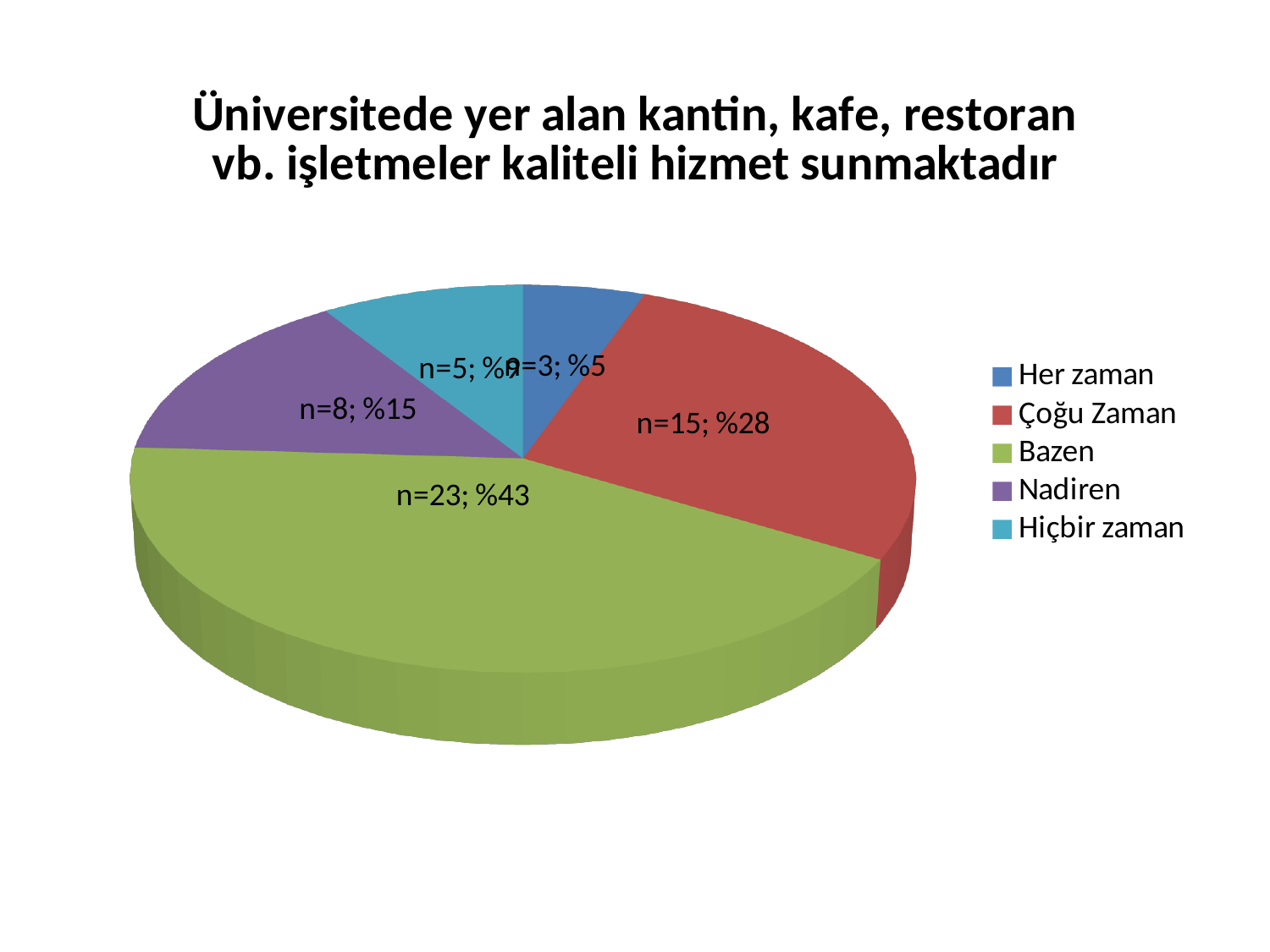
What colour is the Bazen slice in the pie chart? green What is the data label for the Bazen slice? n=23; %43 What is the data label for the Her zaman slice? n=3; %5 Which category has the largest slice of the pie? Bazen How many categories does the pie chart have? 5 What is the difference in n between the Bazen slice and the Çoğu Zaman slice? 8 What is the data label for the Nadiren slice? n=8; %15 Which is larger, the Çoğu Zaman slice or the Nadiren slice? Çoğu Zaman Which category has the smallest slice of the pie? Her zaman What is the data label for the Çoğu Zaman slice? n=15; %28 What share of the pie does the Bazen slice represent? %43 What kind of chart is shown on the slide? pie chart